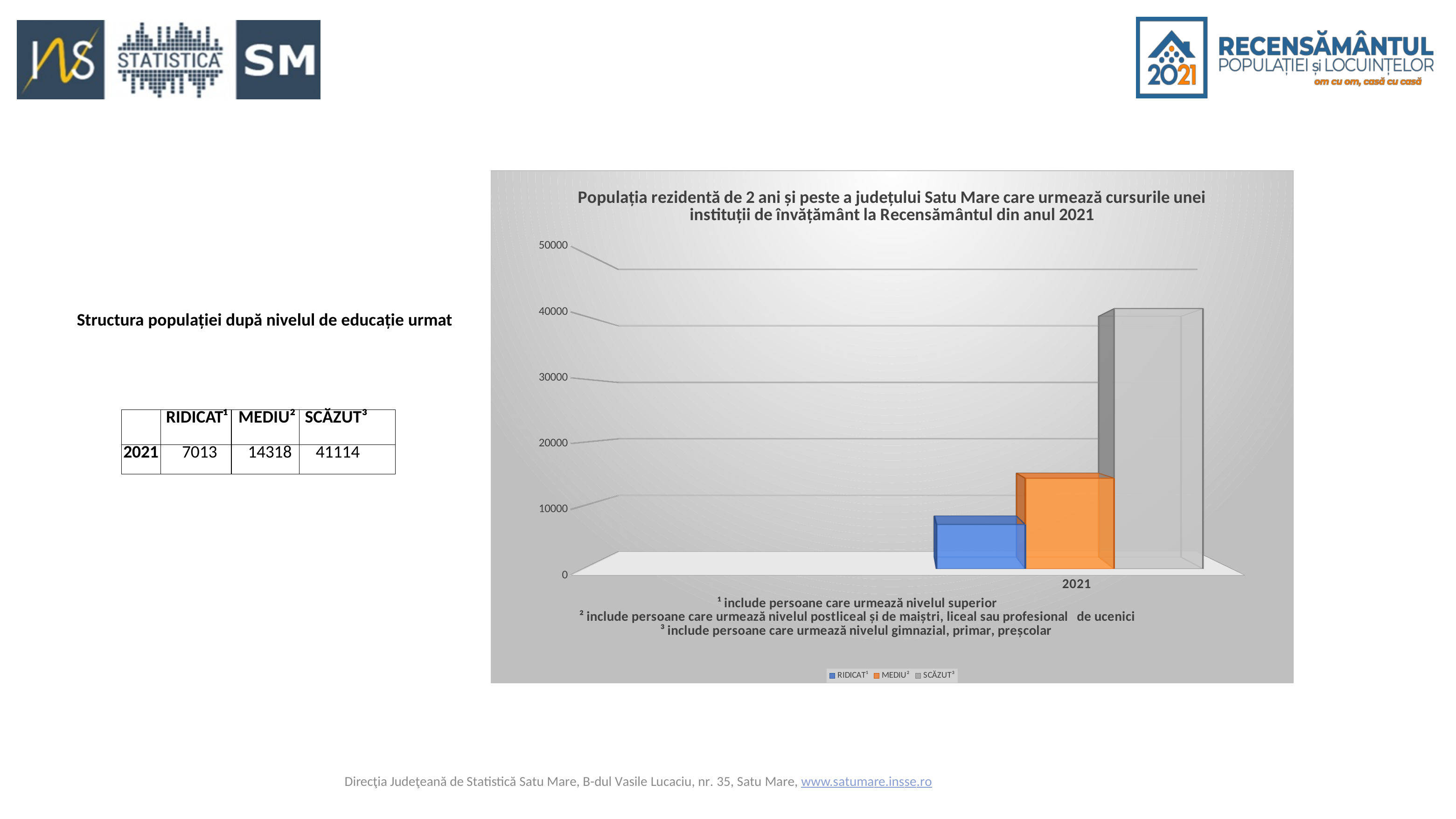
Is the value for SCĂZUT in the chart greater or less than 40000? greater According to the slide, what is the value for RIDICAT in 2021? 7013 According to the slide, what is the value for SCĂZUT in 2021? 41114 Which series has the highest value in the chart for 2021? SCĂZUT Is the value for RIDICAT in the chart greater or less than 10000? less What kind of chart is shown on the slide? bar chart According to the slide, what is the value for MEDIU in 2021? 14318 Which is larger in the chart, MEDIU or RIDICAT? MEDIU Which series has the lowest value in the chart for 2021? RIDICAT What is the difference between the SCĂZUT and MEDIU values shown on the slide for 2021? 26796 How many series does the chart legend list? 3 How many categories are shown on the x axis of the chart? 1